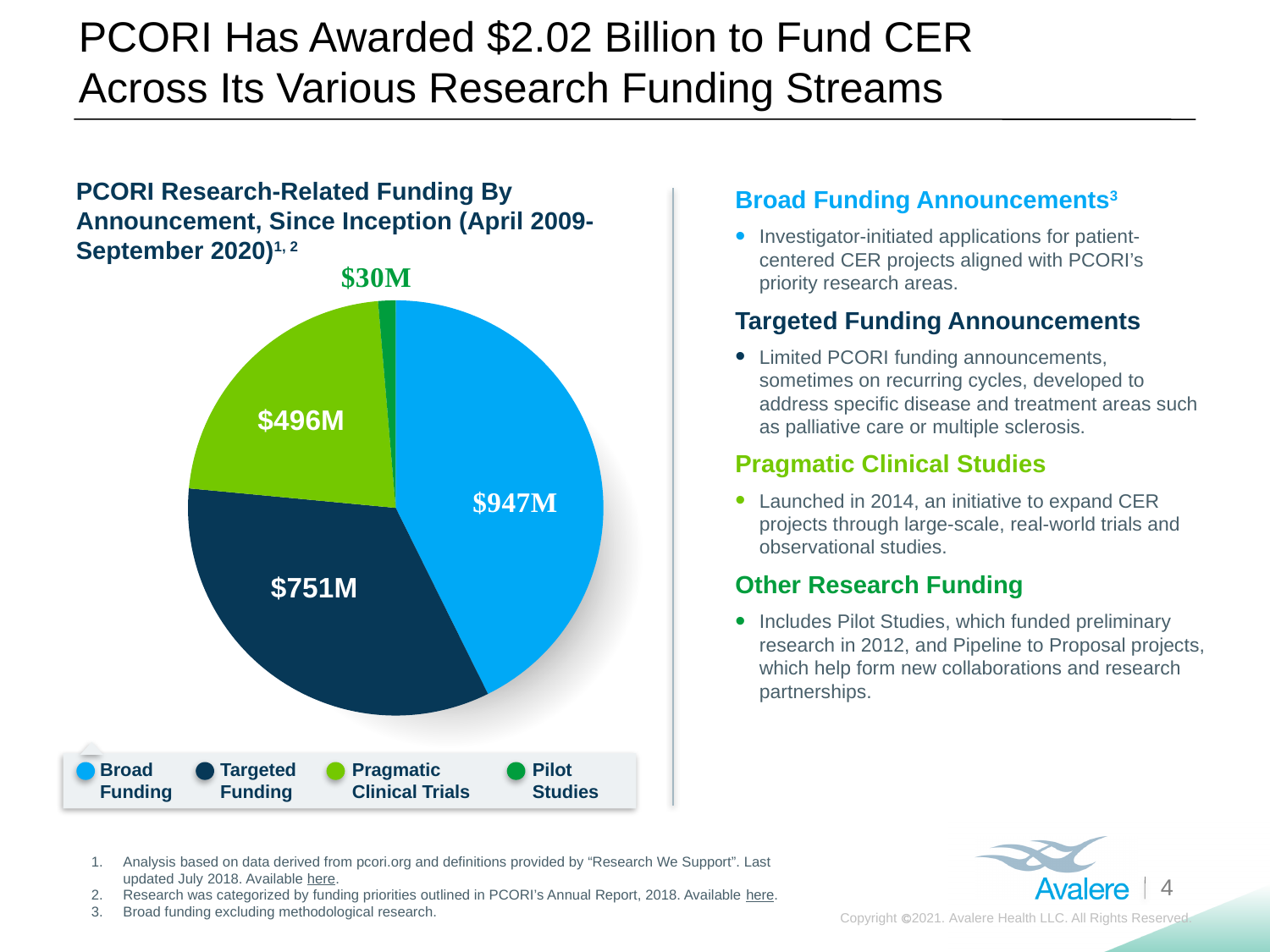
Which funding category has the largest slice of the pie chart? Broad Funding Which is larger, Targeted Funding or Pragmatic Clinical Trials? Targeted Funding What is the difference between the Targeted Funding and Pragmatic Clinical Trials values? $255M Which funding category has the smallest slice of the pie chart? Pilot Studies What is the value for Pilot Studies in the pie chart? $30M What kind of chart is shown on the slide? Pie chart What is the difference between the Broad Funding and Targeted Funding values? $196M What is the value for Pragmatic Clinical Trials in the pie chart? $496M How many slices does the pie chart have? 4 How many entries does the pie chart's legend list? 4 What is the value for Broad Funding in the pie chart? $947M What colour is the Targeted Funding slice in the pie chart? Dark navy blue